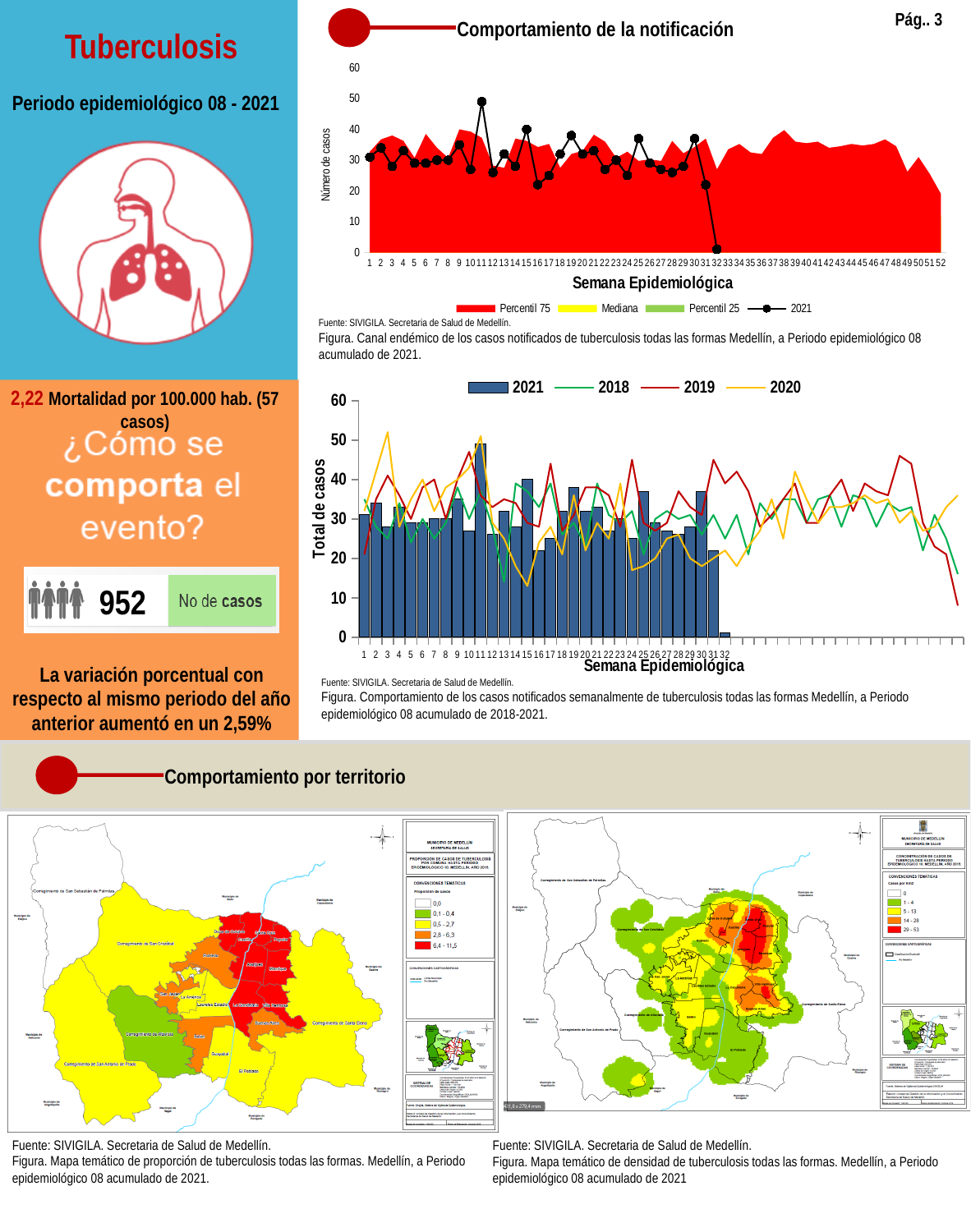
In the bottom chart of weekly cases (2018-2021), at which week is the 2021 bar lowest? 32 In the chart titled 'Comportamiento de la notificación', how many series does the legend list? 4 In the bottom chart of weekly cases (2018-2021), how many series does the legend list? 4 In the bottom chart of weekly cases (2018-2021), at which week is the 2021 bar highest? 11 In the chart titled 'Comportamiento de la notificación', which colour represents Percentil 75 in the legend? Red In the bottom chart of weekly cases (2018-2021), which series is drawn as bars? 2021 In the bottom chart of weekly cases (2018-2021), is the 2021 bar at week 11 greater or less than 40? greater In the chart titled 'Comportamiento de la notificación', how many epidemiological weeks are shown on the x axis? 52 In the chart titled 'Comportamiento de la notificación', is the 2021 value at week 32 greater or less than 10? less In the chart titled 'Comportamiento de la notificación', is the 2021 value at week 11 greater or less than 40? greater In the chart titled 'Comportamiento de la notificación', what is the highest value shown on the y axis? 60